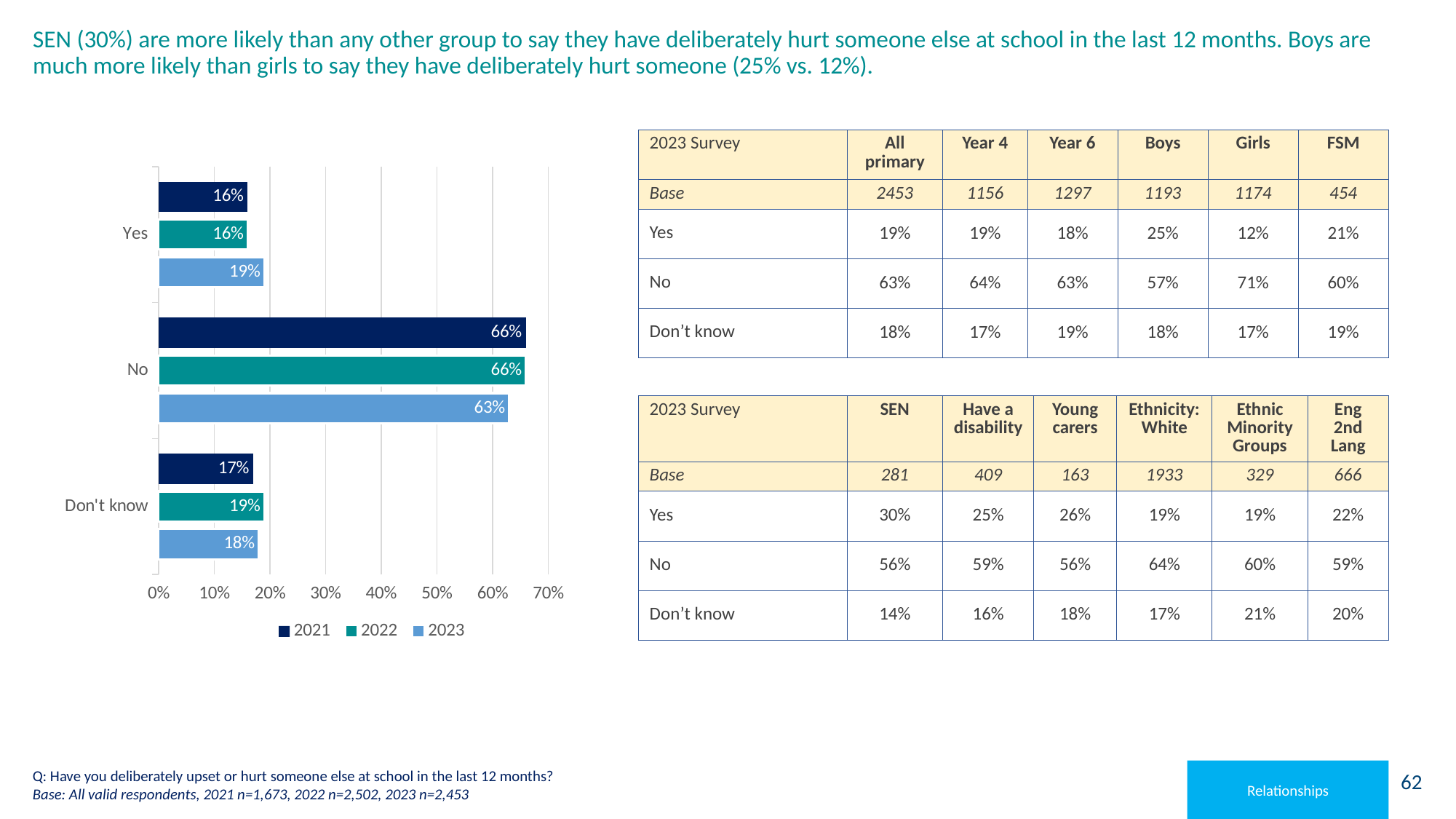
What is the difference between the 'No' value in 2022 and the 'No' value in 2023? 3% How many series does the legend list? 3 Which category has the highest value in 2023? No Which is larger: the 'Yes' value in 2023 or the 'Don't know' value in 2023? Yes How many categories are shown on the chart? 3 What is the value for 'Don't know' in 2022? 19% What is the value for 'No' in 2021? 66% What kind of chart is shown on the slide? bar chart Which series is shown in the darkest blue colour? 2021 Which category has the lowest value in 2021? Yes Is the value for 'No' in 2023 greater or less than 60%? greater What is the value for 'Yes' in 2023? 19%